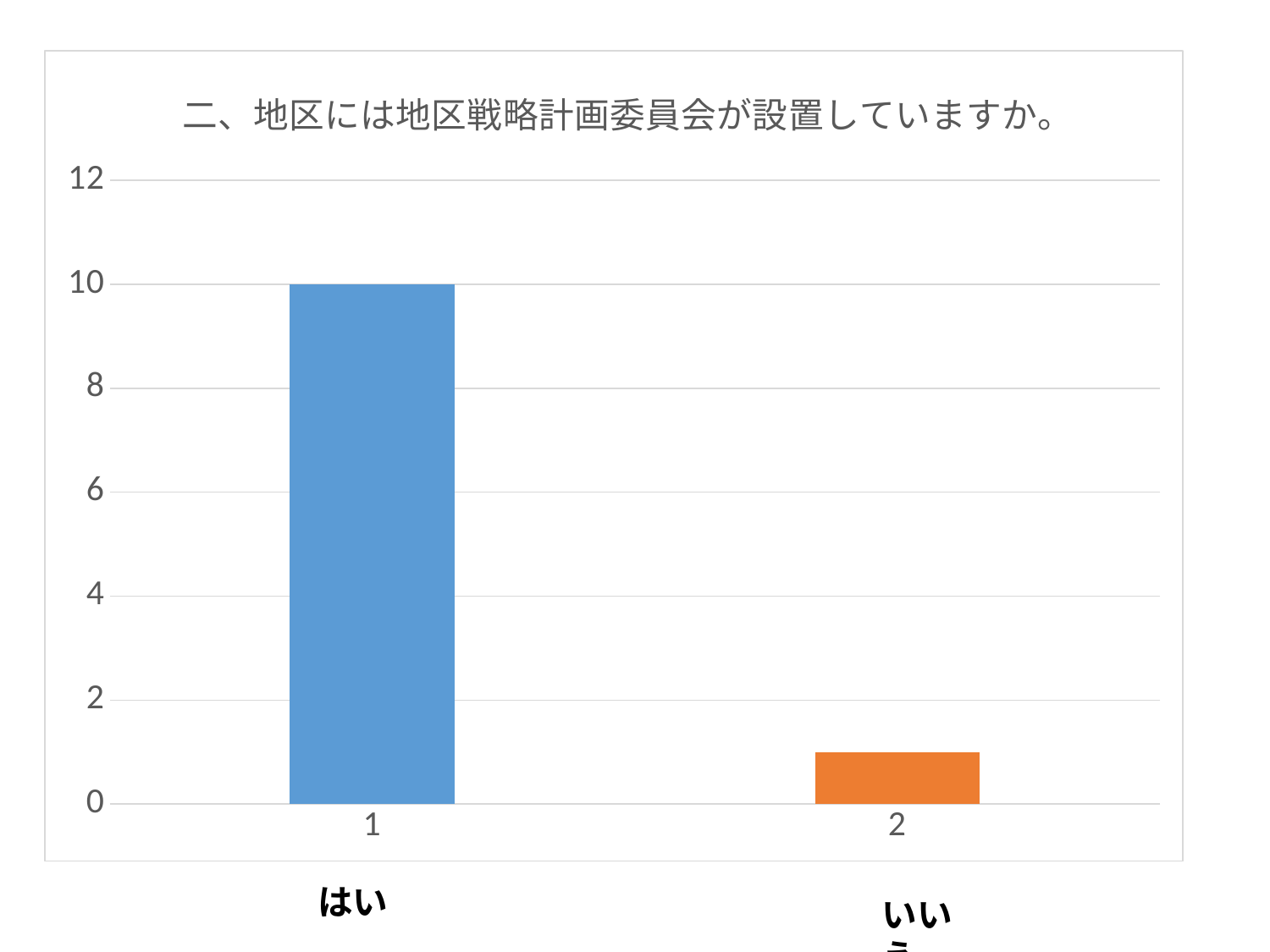
What colour is the bar for category 2? orange Which category has the lowest value? 2 (いいえ) What is the value for category 1 (はい)? 10 Is the value for category 1 (はい) greater or less than 8? greater Is the value for category 2 (いいえ) greater or less than 2? less What is the title of the chart? 二、地区には地区戦略計画委員会が設置していますか。 Which category has the highest value? 1 (はい) How many bars are plotted in the chart? 2 Which is larger, the value for category 1 or the value for category 2? category 1 Is the value for category 2 (いいえ) greater or less than 4? less What kind of chart is shown on the slide? bar chart What is the highest value shown on the vertical axis? 12